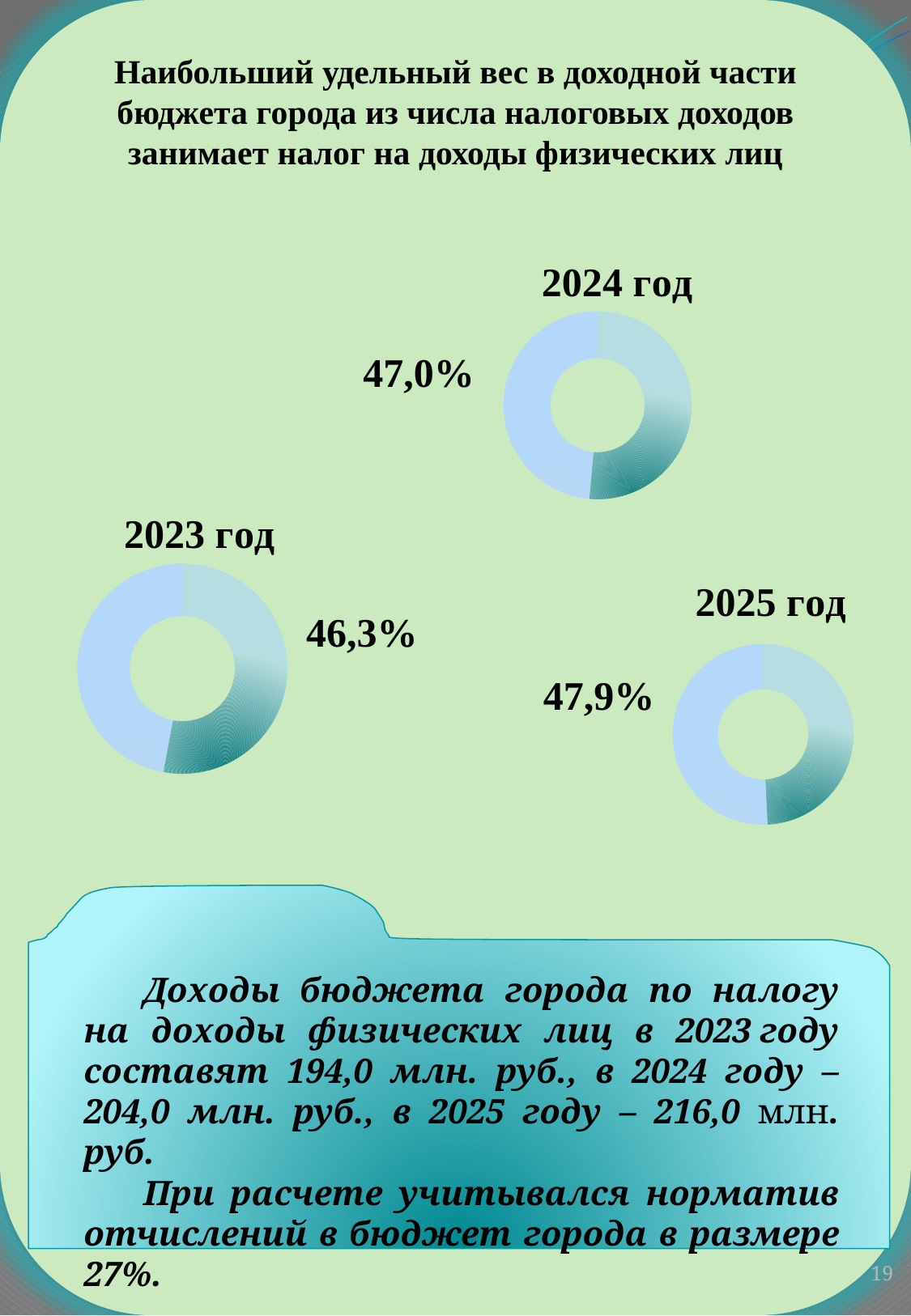
Which is larger: the labelled share in the "2024 год" chart or in the "2023 год" chart? 2024 год Across the three charts (2023 год, 2024 год, 2025 год), which year shows the lowest labelled share? 2023 год In the chart titled "2024 год", what share is shown by the data label? 47,0% In the chart titled "2023 год", what share is shown by the data label? 46,3% In the chart titled "2025 год", what share is shown by the data label? 47,9% Is the labelled share in the "2023 год" chart greater or less than 50%? less What is the difference between the labelled share in the "2025 год" chart and the "2023 год" chart? 1,6% Across the three charts (2023 год, 2024 год, 2025 год), which year shows the highest labelled share? 2025 год How many charts are shown on the slide? 3 What is the difference between the labelled share in the "2024 год" chart and the "2023 год" chart? 0,7% What kind of chart is used for "2024 год"? Donut (pie) chart Do the labelled shares rise or fall from the "2023 год" chart to the "2025 год" chart? rise